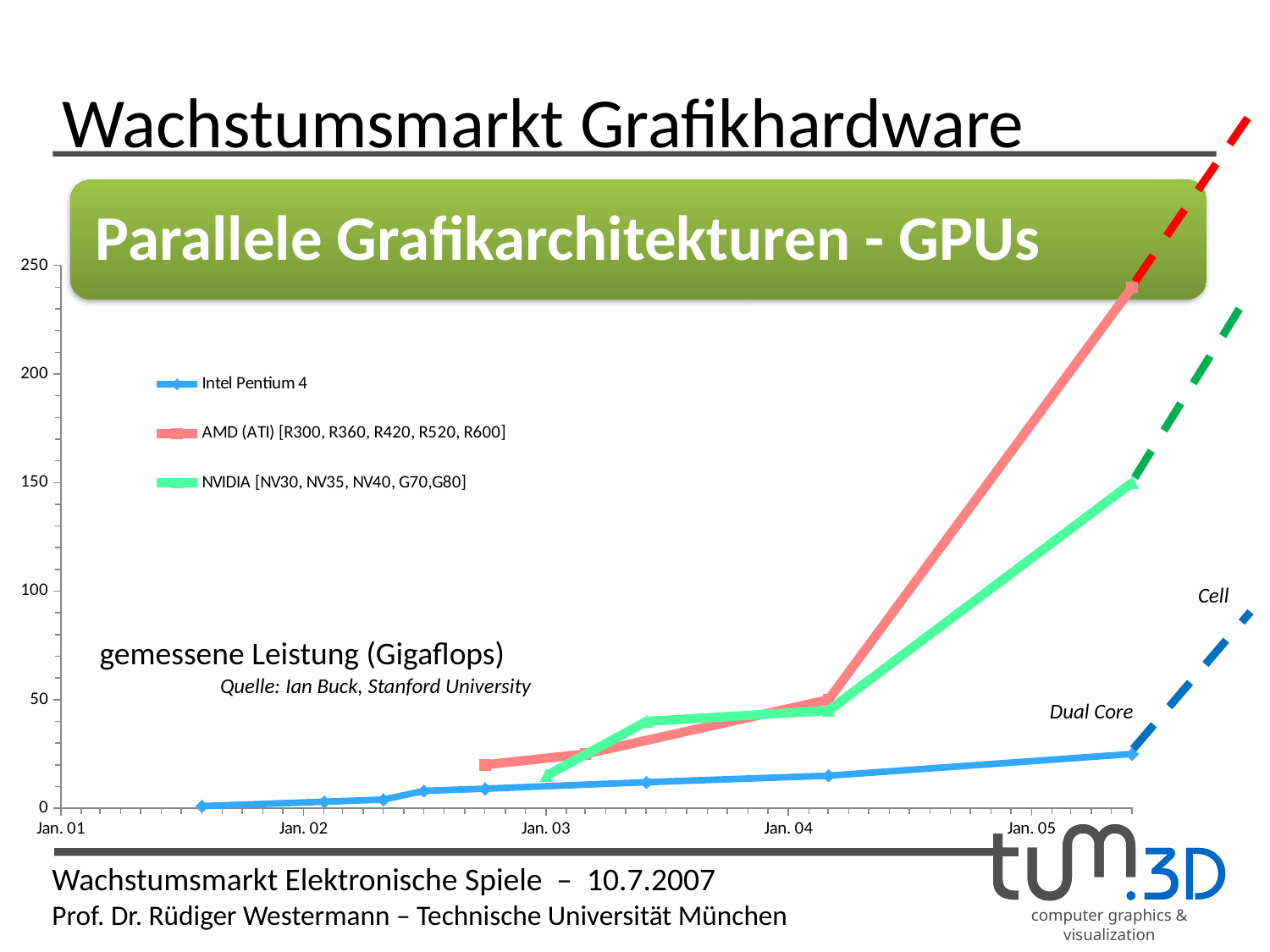
Is the final plotted value for the NVIDIA series greater or less than 100? greater Is the final plotted value for the AMD (ATI) series greater or less than 200? greater What quantity does the chart measure, according to the text on the chart? gemessene Leistung (Gigaflops) At the right end of the chart, which is larger: the NVIDIA value or the Intel Pentium 4 value? NVIDIA How many year labels are shown on the x axis? 5 Which series has the lowest value at the right end of the chart? Intel Pentium 4 Is the final plotted value for the Intel Pentium 4 series greater or less than 50? less What kind of chart is shown on the slide? line chart How many series does the chart legend list? 3 Does the Intel Pentium 4 series rise or fall from Jan. 01 to Jan. 05? rise Which series reaches the highest value at the right end of the chart? AMD (ATI) [R300, R360, R420, R520, R600]